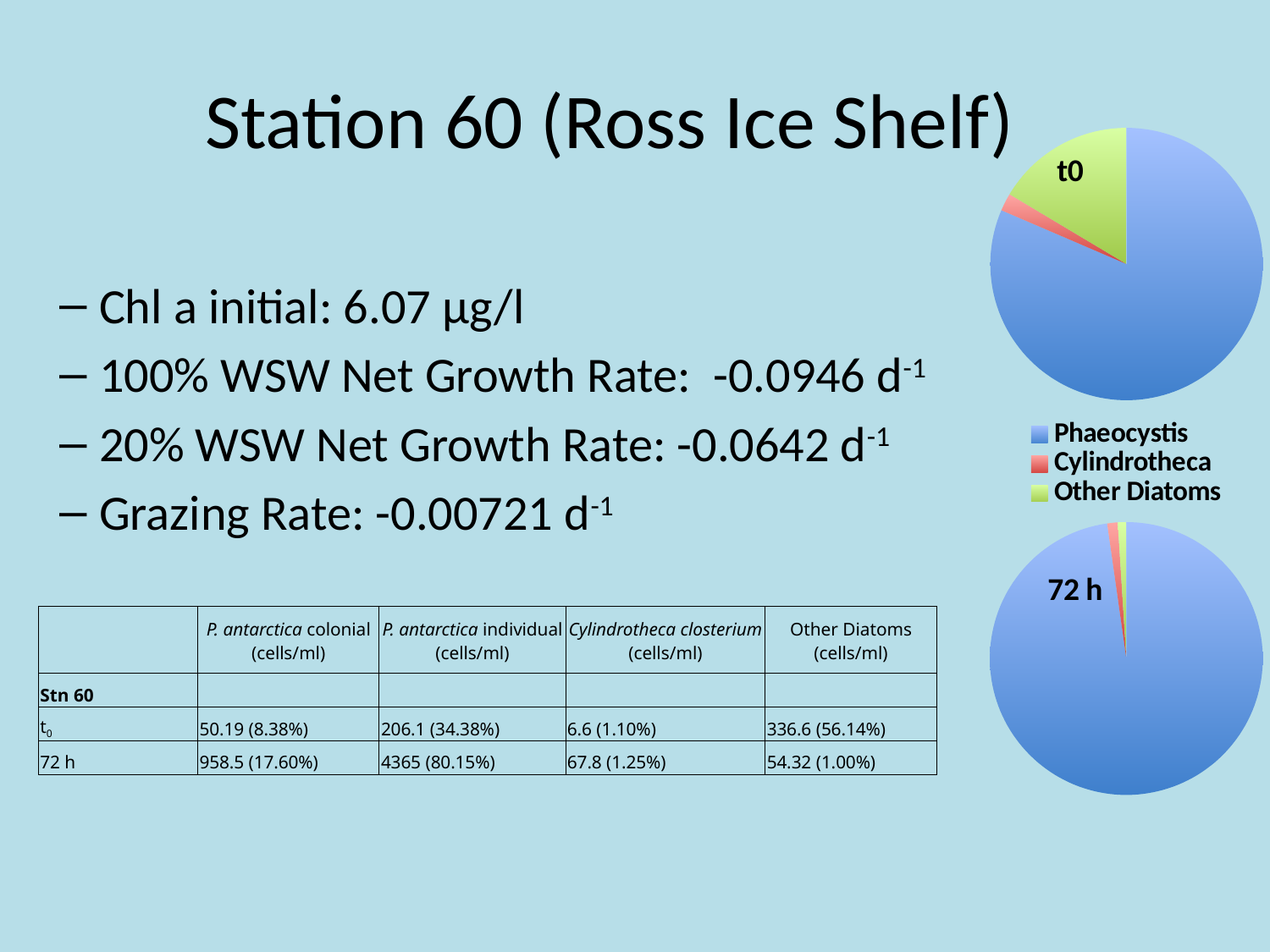
In the 72 h pie chart, which category has the largest slice? Phaeocystis How many entries does the legend shared by the pie charts list? 3 What kind of chart is the chart titled 72 h? pie chart In the t0 pie chart, which category has the smallest slice? Cylindrotheca What kind of chart is the chart titled t0? pie chart How many slices does the t0 pie chart have? 3 In the 72 h pie chart, which slice is larger, Phaeocystis or Cylindrotheca? Phaeocystis In the t0 pie chart, which category has the largest slice? Phaeocystis In the t0 pie chart, which slice is larger, Other Diatoms or Cylindrotheca? Other Diatoms Which colour represents Phaeocystis in the pie charts? blue What is the title of the upper pie chart on the slide? t0